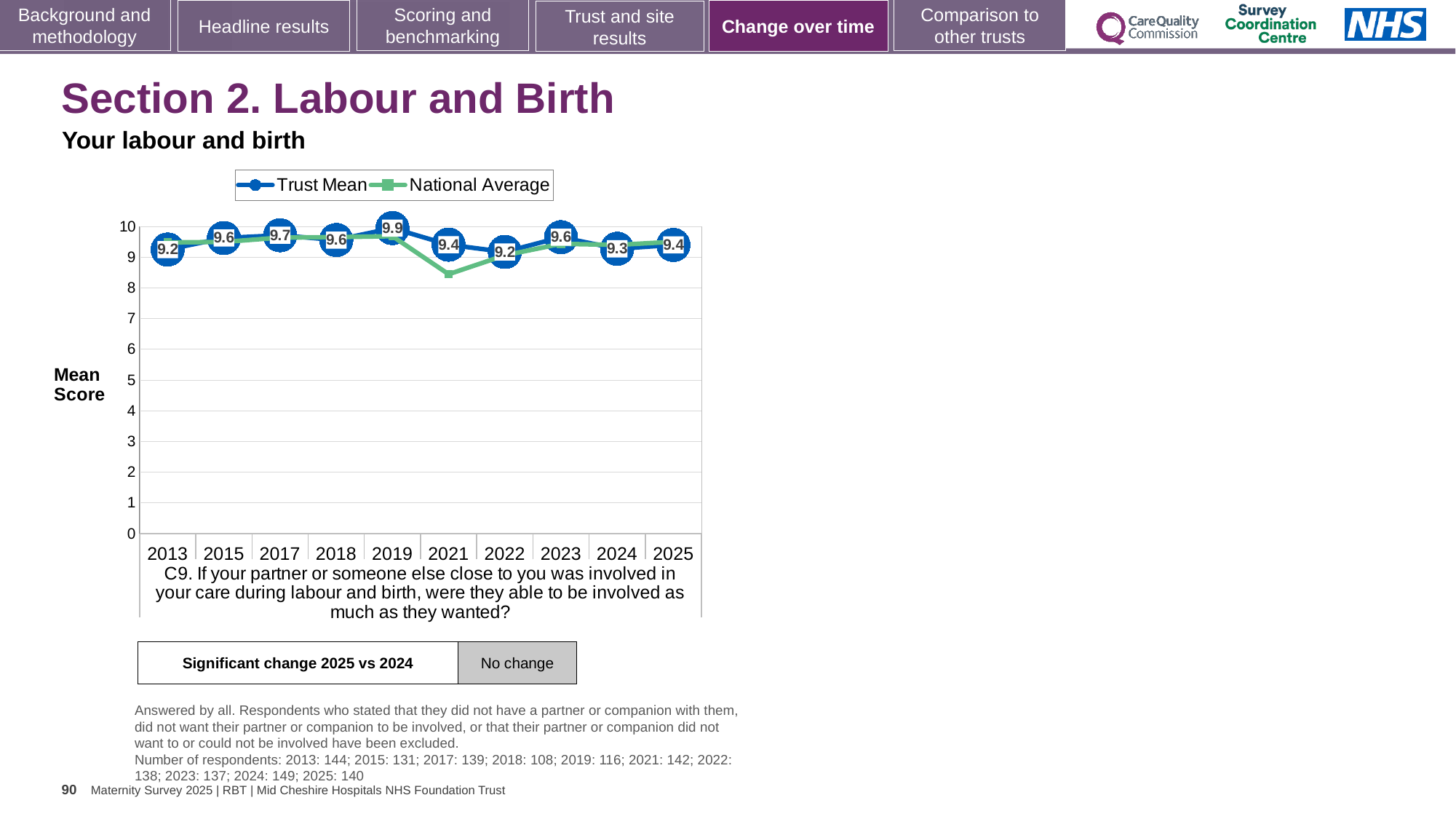
What is the Trust Mean score for 2013? 9.2 What is the Trust Mean score for 2019? 9.9 Which year has the higher Trust Mean score, 2017 or 2024? 2017 Is the National Average value for 2021 greater or less than 9? less What is the lowest Trust Mean score shown on the chart? 9.2 Does the Trust Mean score rise or fall from 2024 to 2025? rise What is the difference between the Trust Mean scores for 2019 and 2022? 0.7 How many series does the legend list? 2 What kind of chart is shown on the slide? line chart How many years are plotted on the x axis? 10 What is the Trust Mean score for 2025? 9.4 In which year is the Trust Mean score highest? 2019